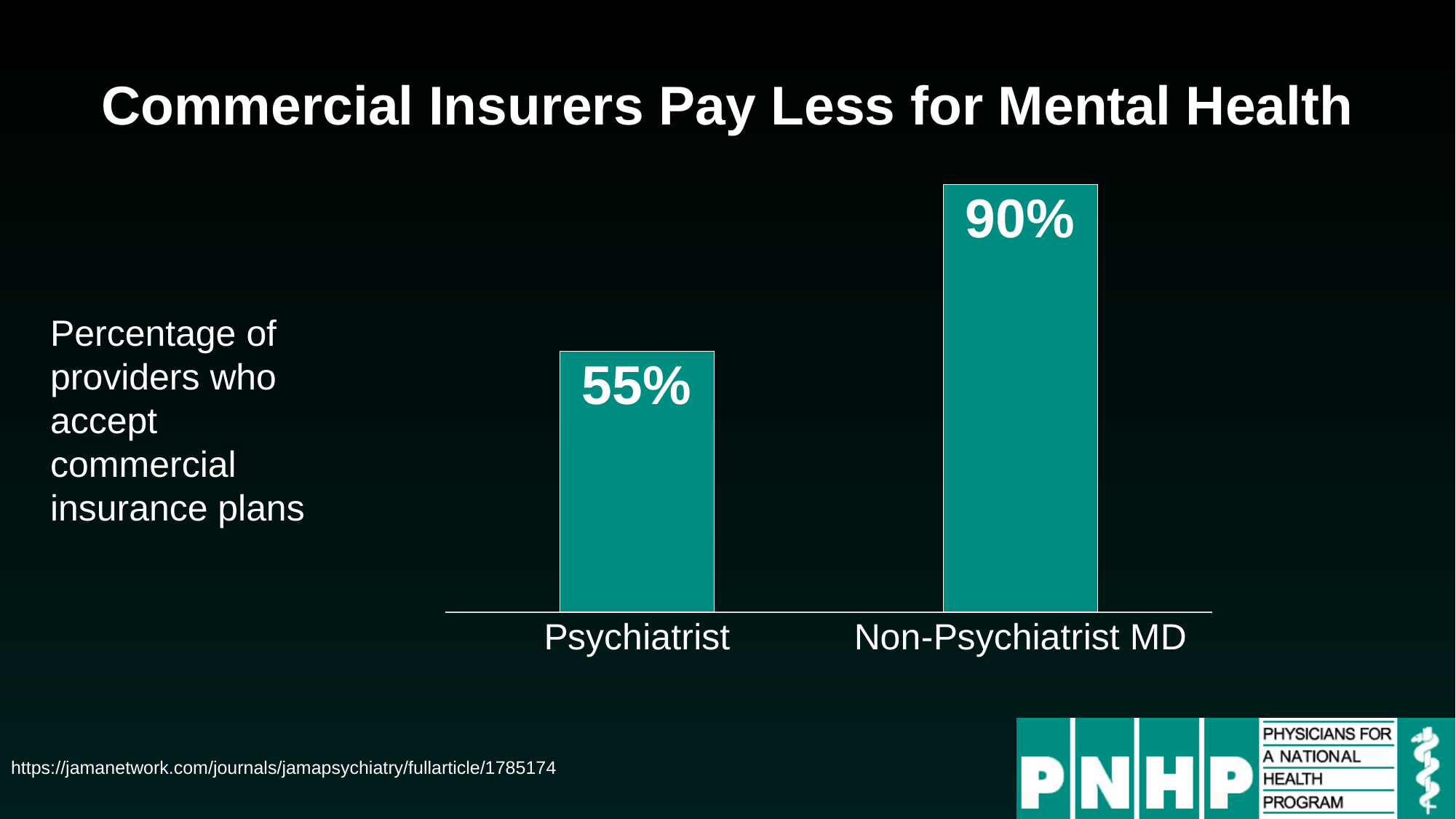
What is the difference in percentage points between Non-Psychiatrist MD and Psychiatrist? 35 What colour are the bars in the chart? teal Is the value for Psychiatrist larger or smaller than the value for Non-Psychiatrist MD? smaller Which provider category has the lower percentage accepting commercial insurance plans? Psychiatrist How many provider categories are shown in the chart? 2 What percentage of psychiatrists accept commercial insurance plans? 55% What percentage of non-psychiatrist MDs accept commercial insurance plans? 90% Which provider category has the higher percentage accepting commercial insurance plans? Non-Psychiatrist MD What kind of chart is shown on the slide? bar chart What is the title of the slide containing the chart? Commercial Insurers Pay Less for Mental Health